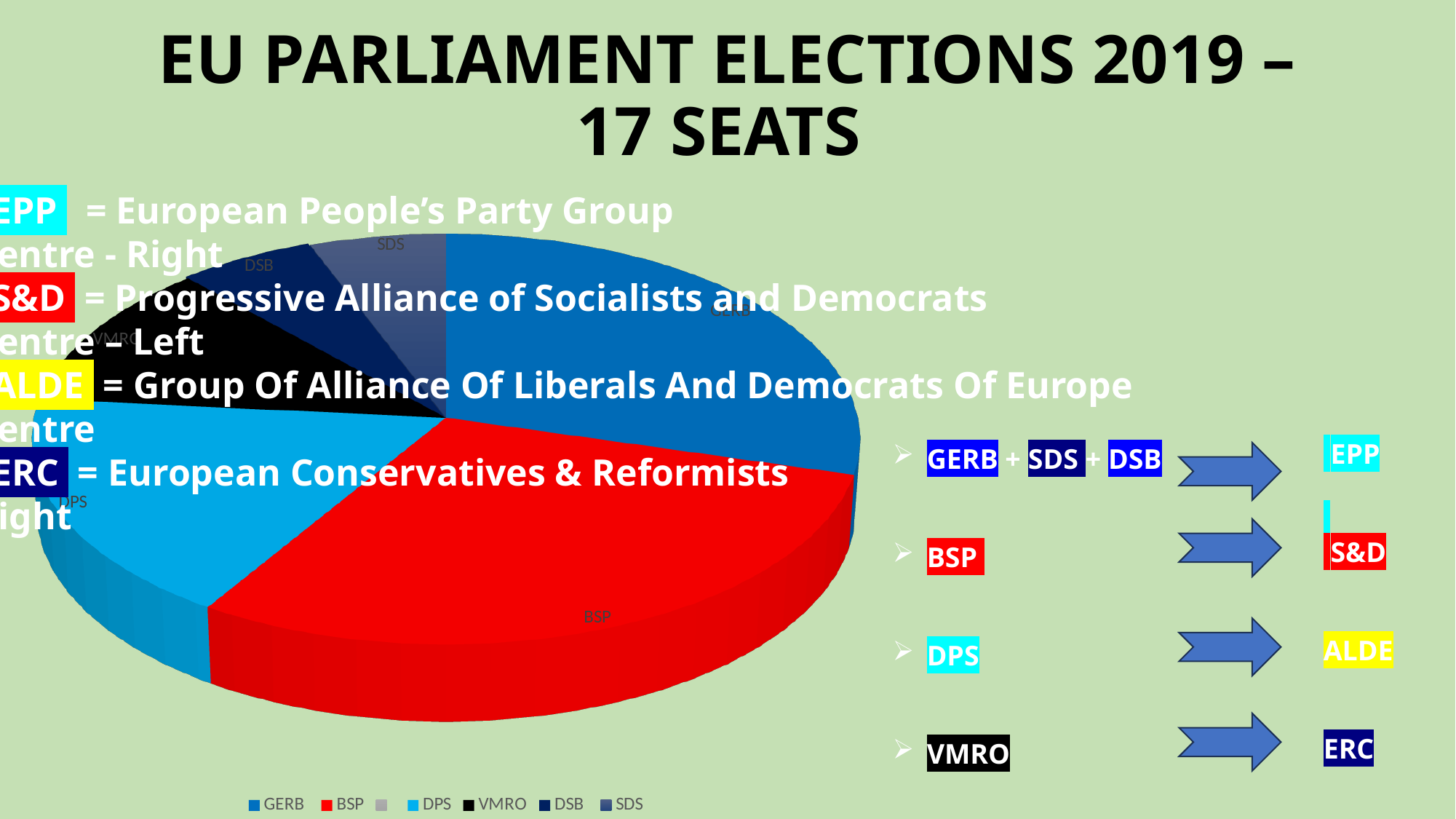
Which slice is larger in the pie chart, DPS or DSB? DPS Which slice is larger in the pie chart, BSP or DPS? BSP How many labelled slices does the pie chart have? 6 Which slice is larger in the pie chart, GERB or VMRO? GERB Which party is represented by the black slice in the pie chart? VMRO What kind of chart is shown on the slide? pie chart What colour is the BSP slice in the pie chart? red